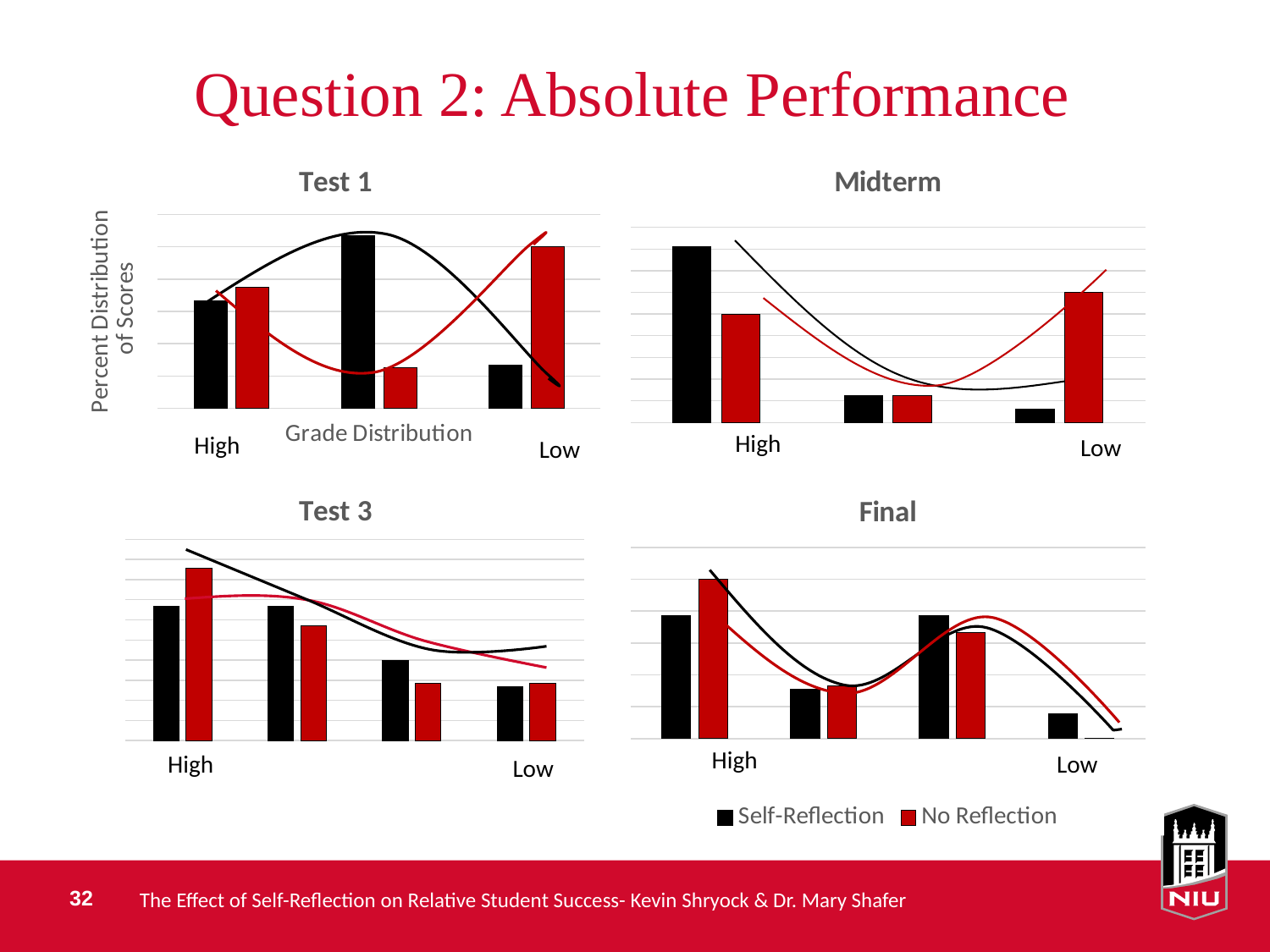
How many series does the legend list for the charts on this slide? 2 How many category groups of bars are shown in the Midterm chart? 3 What is the y-axis label shown next to the Test 1 chart? Percent Distribution of Scores In the Test 1 chart, which series has the taller bar at Low? No Reflection What kind of chart is the Test 1 chart? bar chart In the Test 3 chart, do the Self-Reflection bars rise or fall from High to Low? fall How many category groups of bars are shown in the Test 3 chart? 4 In the Final chart, which series has the taller bar at High? No Reflection In the Final chart, which category has the lowest No Reflection bar? Low In the Midterm chart, which series has the taller bar at High? Self-Reflection In the Midterm chart, which category has the lowest Self-Reflection bar? Low In the Midterm chart, which category has the highest Self-Reflection bar? High